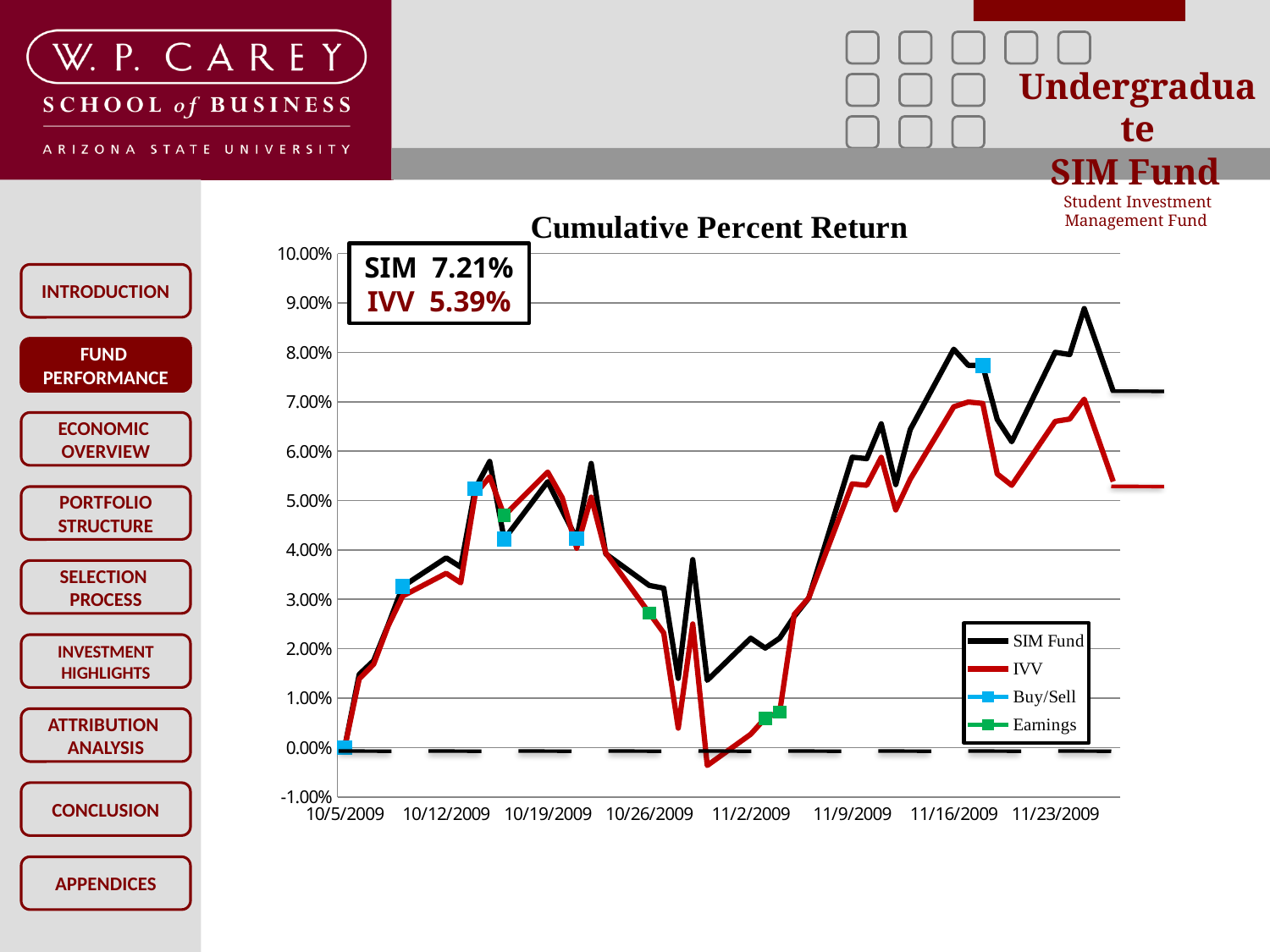
What is the title of the chart? Cumulative Percent Return Overall, does the SIM Fund line rise or fall from 10/5/2009 to the end of the period? rise By how many percentage points does the SIM return (7.21%) exceed the IVV return (5.39%)? 1.82% Is the highest point of the IVV line greater or less than 8.00%? less What cumulative percent return is shown for IVV in the text box on the chart? 5.39% Is the lowest point of the IVV line greater or less than 0.00%? less What cumulative percent return is shown for SIM in the text box on the chart? 7.21% How many entries does the chart legend list? 4 What colour is the IVV line in the chart? red What kind of chart is shown on the slide? line chart Is the highest point of the SIM Fund line greater or less than 8.00%? greater Which has the higher cumulative return at the end of the period, SIM Fund or IVV? SIM Fund